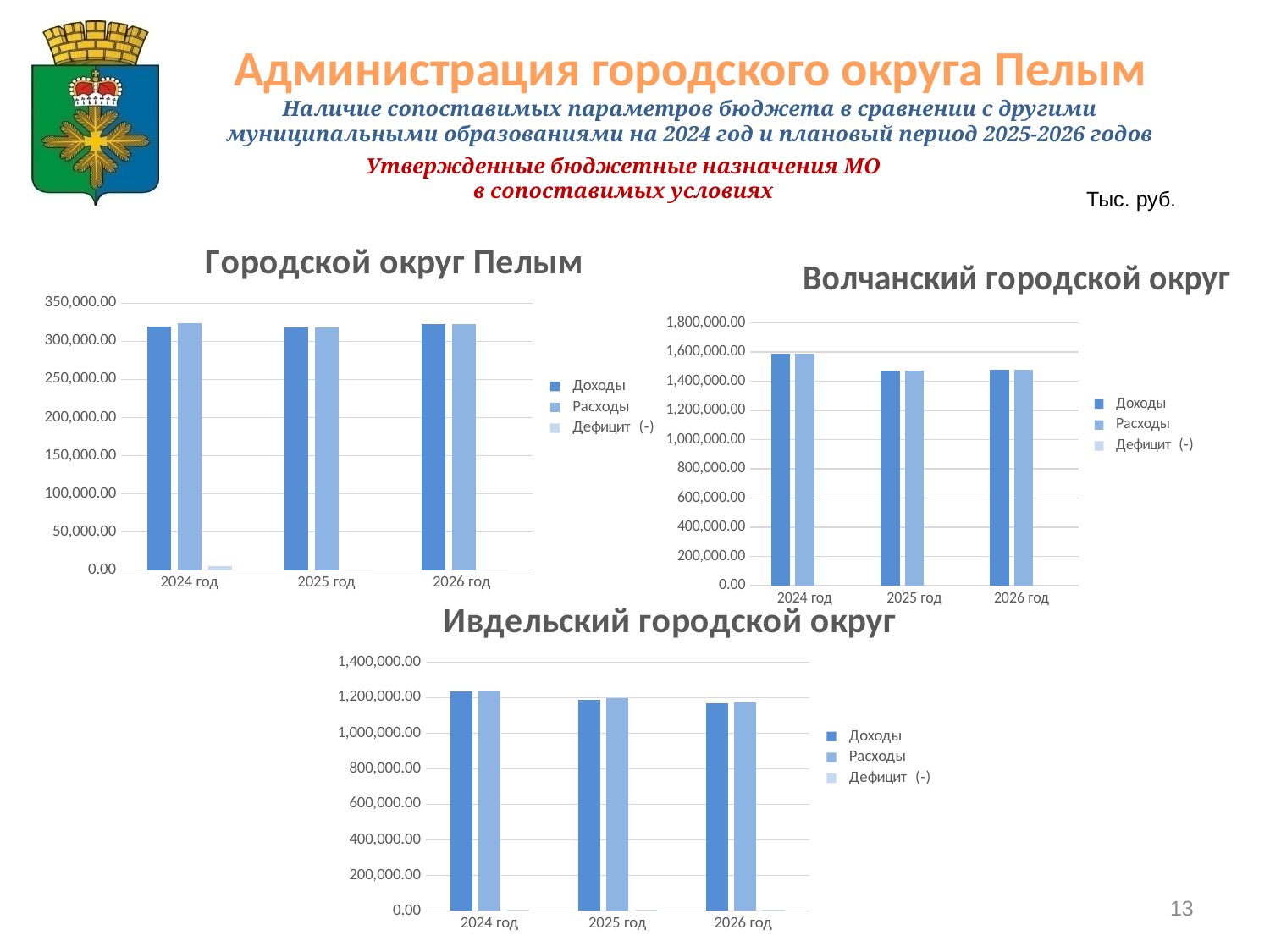
How many year categories are shown on the x axis of the chart titled 'Городской округ Пелым'? 3 In the chart titled 'Ивдельский городской округ', is the value for Доходы in 2024 год greater or less than 1,000,000.00? greater In the chart titled 'Городской округ Пелым', is the value for Доходы in 2024 год greater or less than 300,000.00? greater In the chart titled 'Ивдельский городской округ', do the Доходы values rise or fall from 2024 год to 2026 год? fall In the chart titled 'Ивдельский городской округ', is the value for Расходы in 2026 год greater or less than 1,200,000.00? less In the chart titled 'Волчанский городской округ', which year has the highest value for Доходы? 2024 год What kind of chart is the chart titled 'Волчанский городской округ'? bar chart How many series does the legend of the chart titled 'Ивдельский городской округ' list? 3 In the chart titled 'Ивдельский городской округ', which year has the highest value for Доходы? 2024 год In the chart titled 'Волчанский городской округ', which is larger: Доходы in 2024 год or Доходы in 2025 год? Доходы in 2024 год